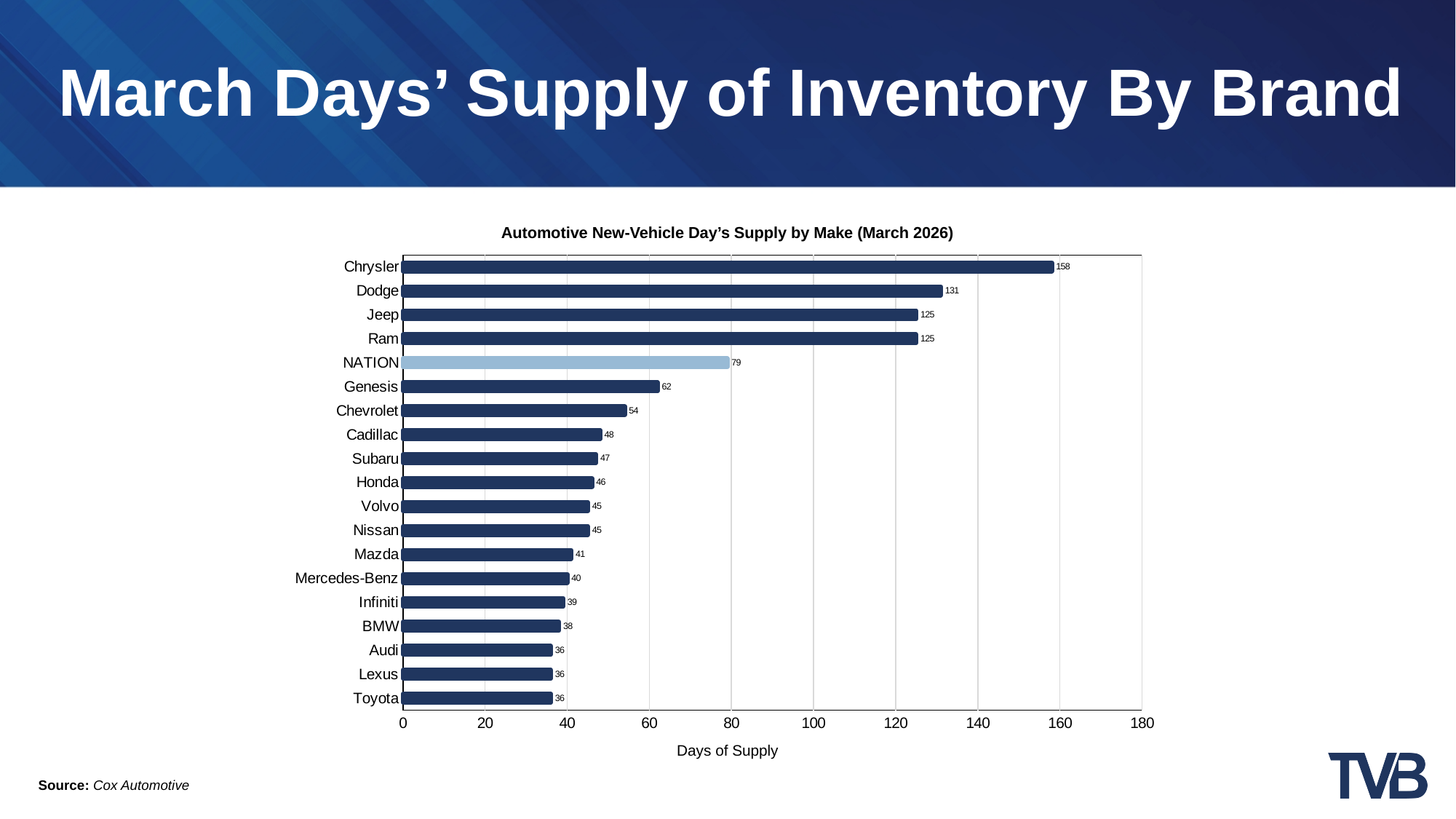
What kind of chart is shown on the slide? Bar chart What is the days' supply value for Chrysler? 158 What is the difference in days' supply between NATION and Toyota? 43 What is the difference in days' supply between Chrysler and Dodge? 27 What is the label on the horizontal axis of the chart? Days of Supply Which has a larger days' supply, Dodge or Jeep? Dodge What is the title of the chart? Automotive New-Vehicle Day's Supply by Make (March 2026) What is the days' supply value for Genesis? 62 Which has a larger days' supply, Chevrolet or Cadillac? Chevrolet What is the days' supply value for NATION? 79 How many brands (categories) are shown on the chart? 19 Which brand has the highest days' supply? Chrysler